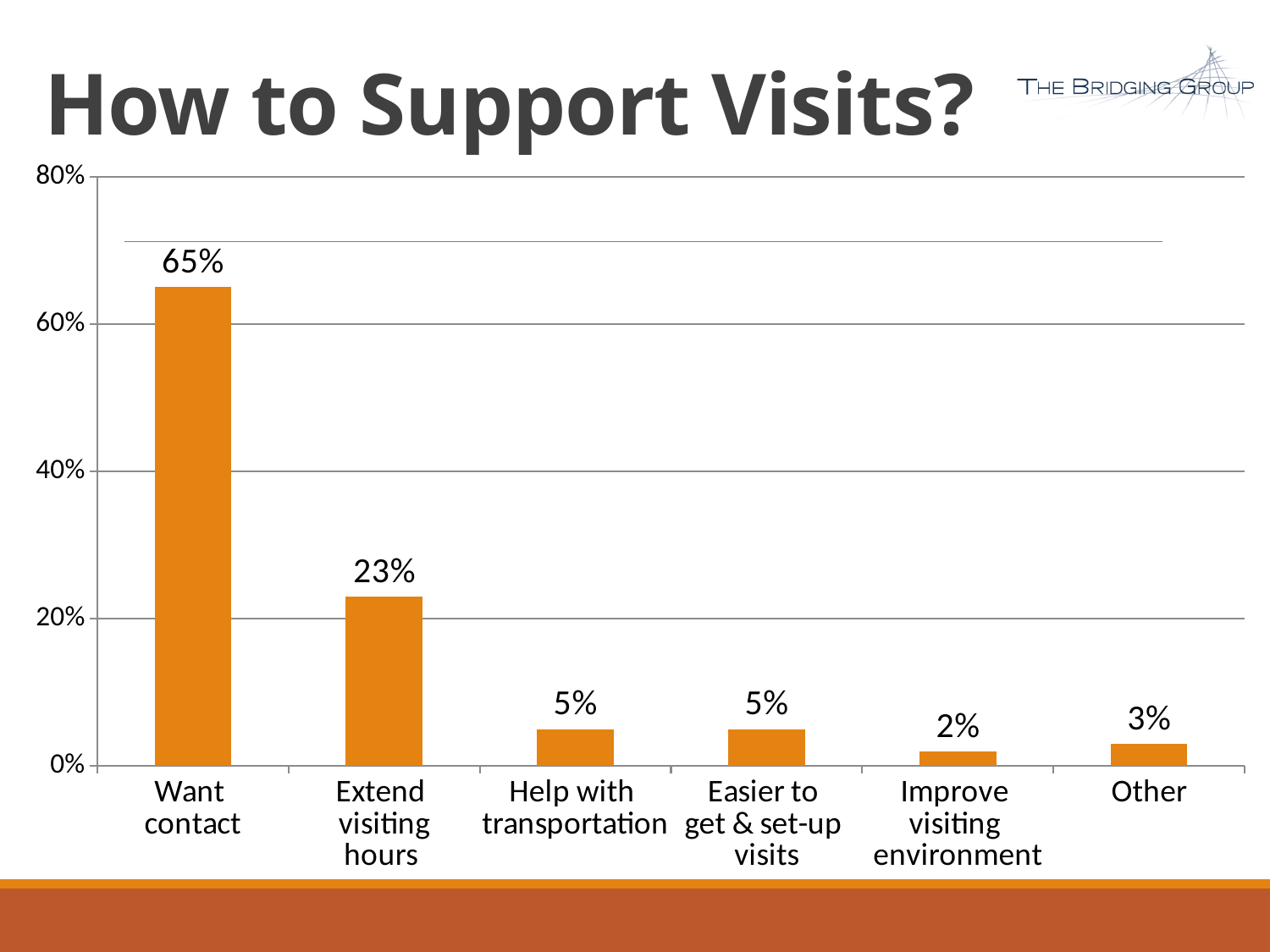
Is the value for Want contact greater or less than 60%? greater What is the difference between the values for Want contact and Extend visiting hours? 42% What kind of chart is shown on the slide? bar chart What is the value for Want contact? 65% What is the value for Improve visiting environment? 2% Which category has the lowest value? Improve visiting environment Which is larger, the value for Other or the value for Improve visiting environment? Other What is the value for Other? 3% Which category has the highest value? Want contact What is the title of the slide? How to Support Visits? How many categories are shown on the x axis? 6 What is the value for Extend visiting hours? 23%